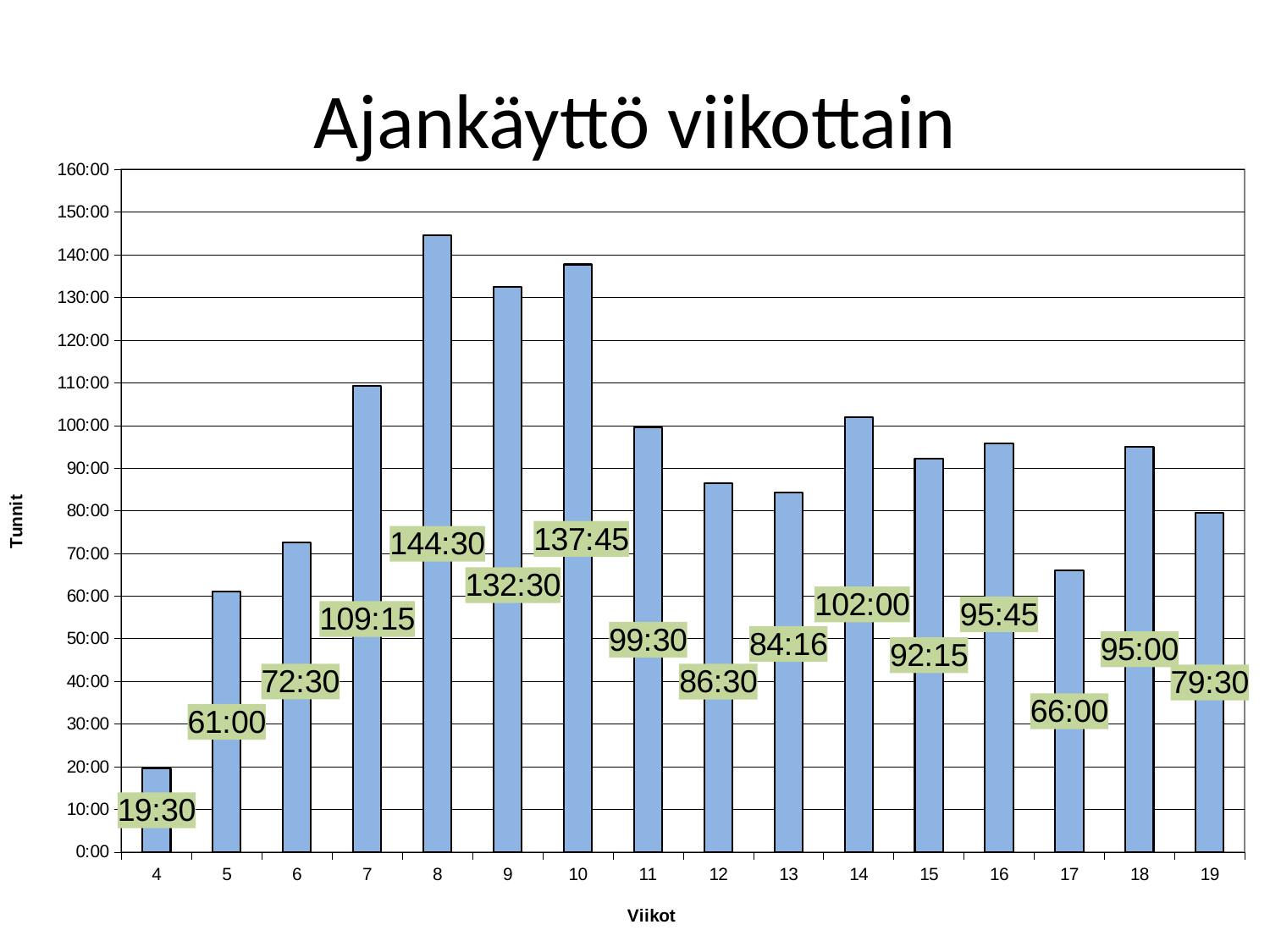
Which week has the lowest value? 4 What kind of chart is shown on the slide? bar chart Which week has the highest value? 8 What is the value for week 17? 66:00 What is the value for week 13? 84:16 What is the difference between the values for week 8 and week 4? 125:00 What is the value for week 8? 144:30 How many weeks are plotted on the x axis? 16 Do the values rise or fall from week 4 to week 8? rise What is the difference between the values for week 10 and week 9? 5:15 Which is larger, the value for week 7 or the value for week 11? week 7 What is the title of the chart? Ajankäyttö viikottain